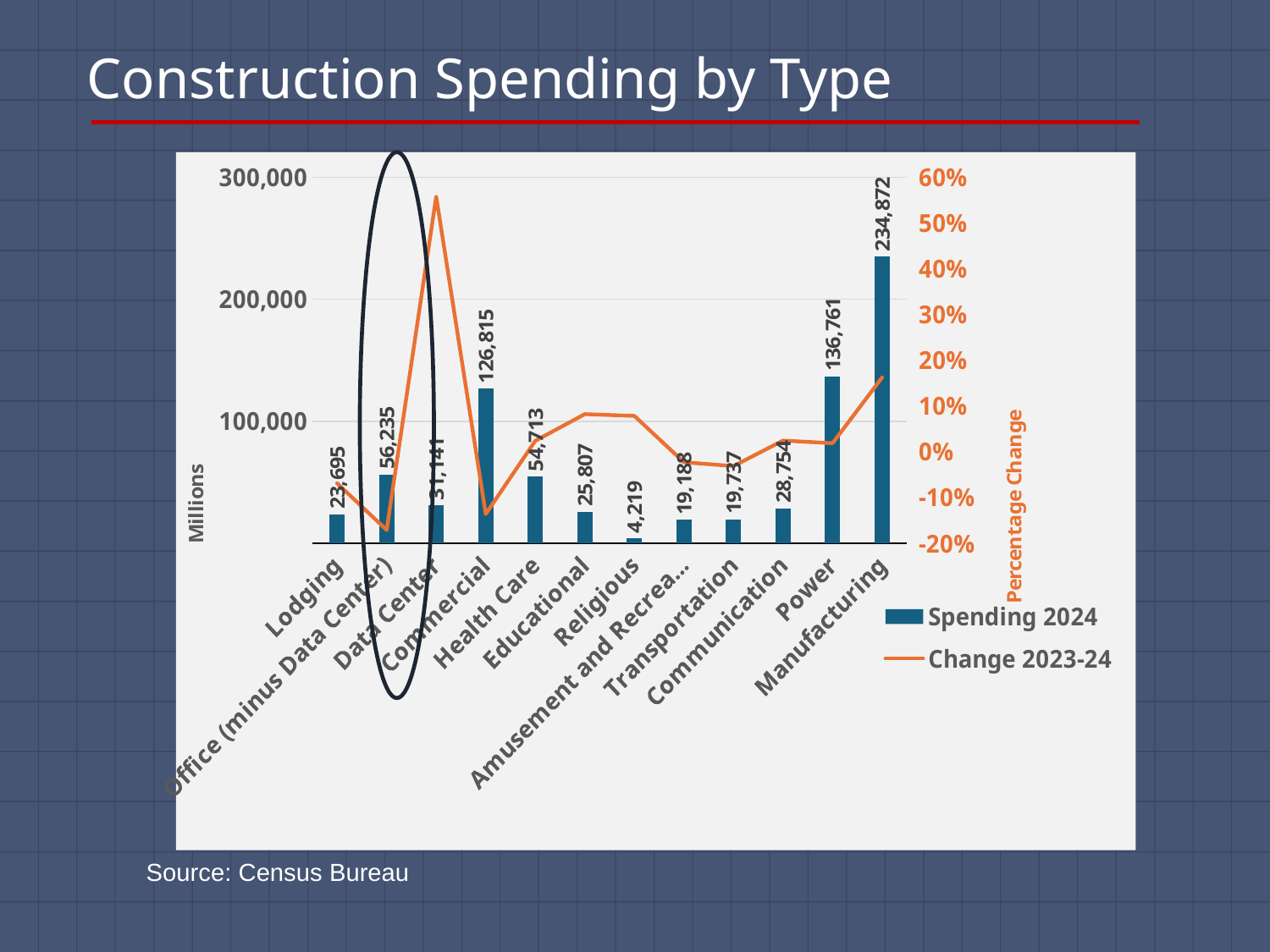
Which has higher Spending 2024: Office (minus Data Center) or Health Care? Office (minus Data Center) Is the Change 2023-24 value for Data Center greater or less than 40%? greater Which category has the highest Spending 2024? Manufacturing What is the Spending 2024 value for Data Center? 31,141 What is the Spending 2024 value for Manufacturing? 234,872 What is the difference in Spending 2024 between Power and Commercial? 9,946 How many construction type categories are shown on the x axis? 12 How many series does the legend list? 2 Which category has the lowest Spending 2024? Religious Which category on the chart is circled? Office (minus Data Center) Is the Change 2023-24 value for Office (minus Data Center) greater or less than -10%? less What is the Spending 2024 value for Lodging? 23,695